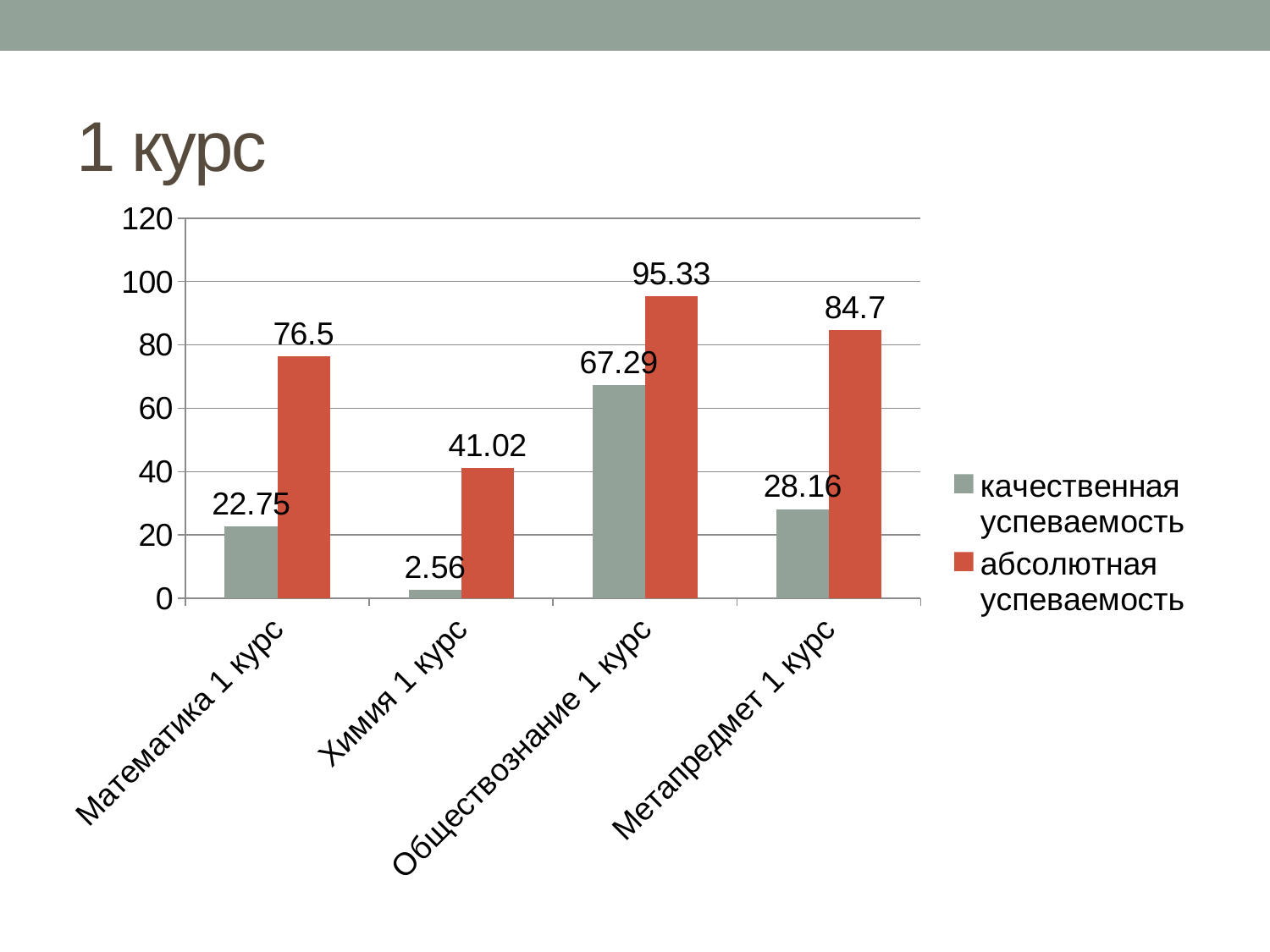
What is the value of абсолютная успеваемость for Обществознание 1 курс? 95.33 Is the value of абсолютная успеваемость for Обществознание 1 курс greater or less than 80? greater What is the value of качественная успеваемость for Математика 1 курс? 22.75 What kind of chart is shown on the slide? bar chart Which is larger: абсолютная успеваемость for Математика 1 курс or абсолютная успеваемость for Метапредмет 1 курс? Метапредмет 1 курс How many series does the legend list? 2 Which category has the lowest абсолютная успеваемость? Химия 1 курс What is the title of the slide? 1 курс What is the difference between абсолютная успеваемость and качественная успеваемость for Метапредмет 1 курс? 56.54 What is the value of абсолютная успеваемость for Химия 1 курс? 41.02 How many categories are shown on the x axis? 4 Which category has the highest качественная успеваемость? Обществознание 1 курс